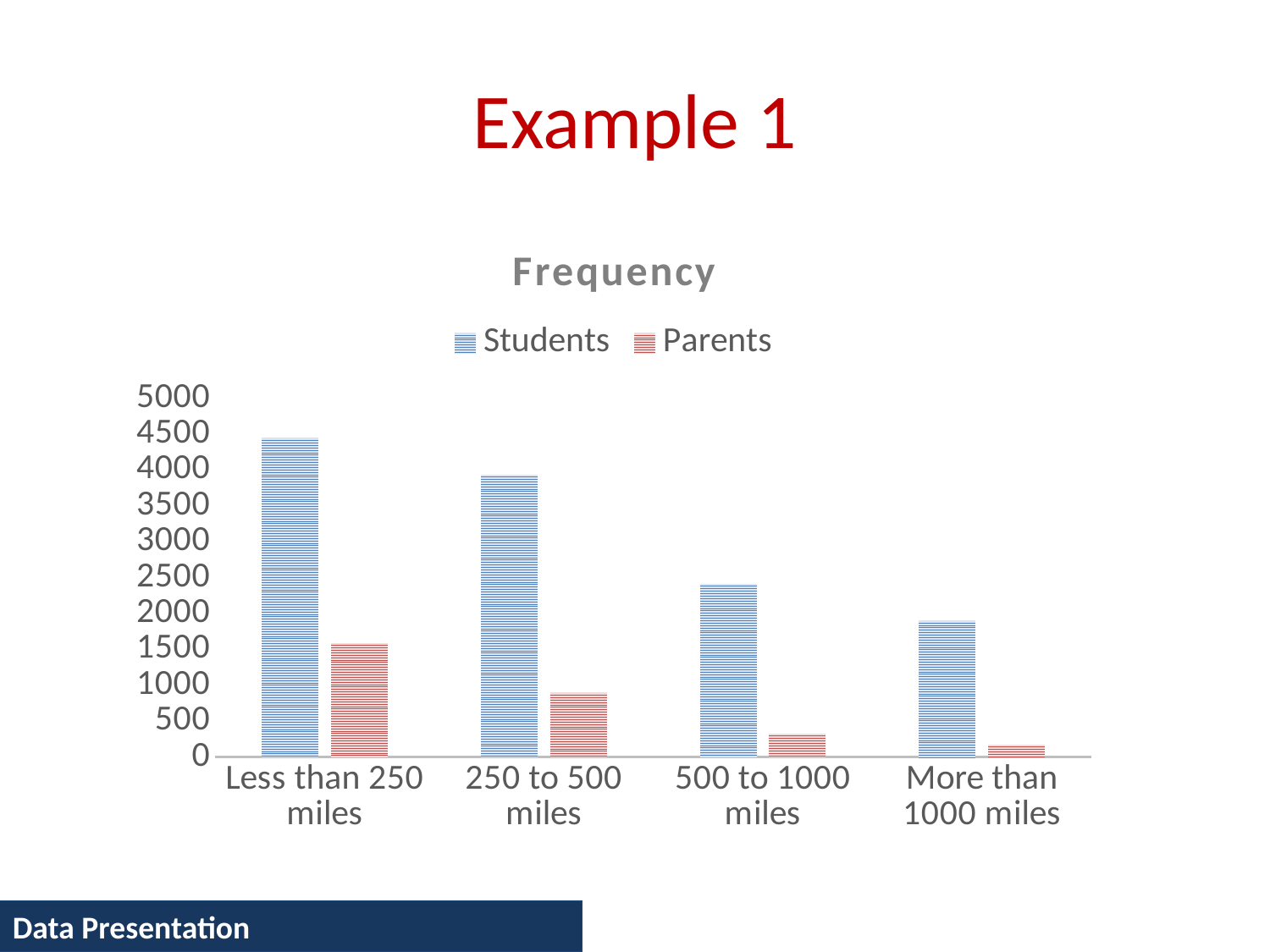
Is the Parents value for Less than 250 miles greater or less than 1000? greater Do the Students values rise or fall as the distance categories increase along the x axis? fall What is the title of the chart? Frequency How many series does the legend list? 2 Which category has the highest Students value? Less than 250 miles Which is larger for 250 to 500 miles, the Students value or the Parents value? Students Is the Students value for 500 to 1000 miles greater or less than 2000? greater Which category has the lowest Parents value? More than 1000 miles Is the Parents value for 250 to 500 miles greater or less than 1000? less How many distance categories are shown on the x axis? 4 What kind of chart is shown on the slide? bar chart